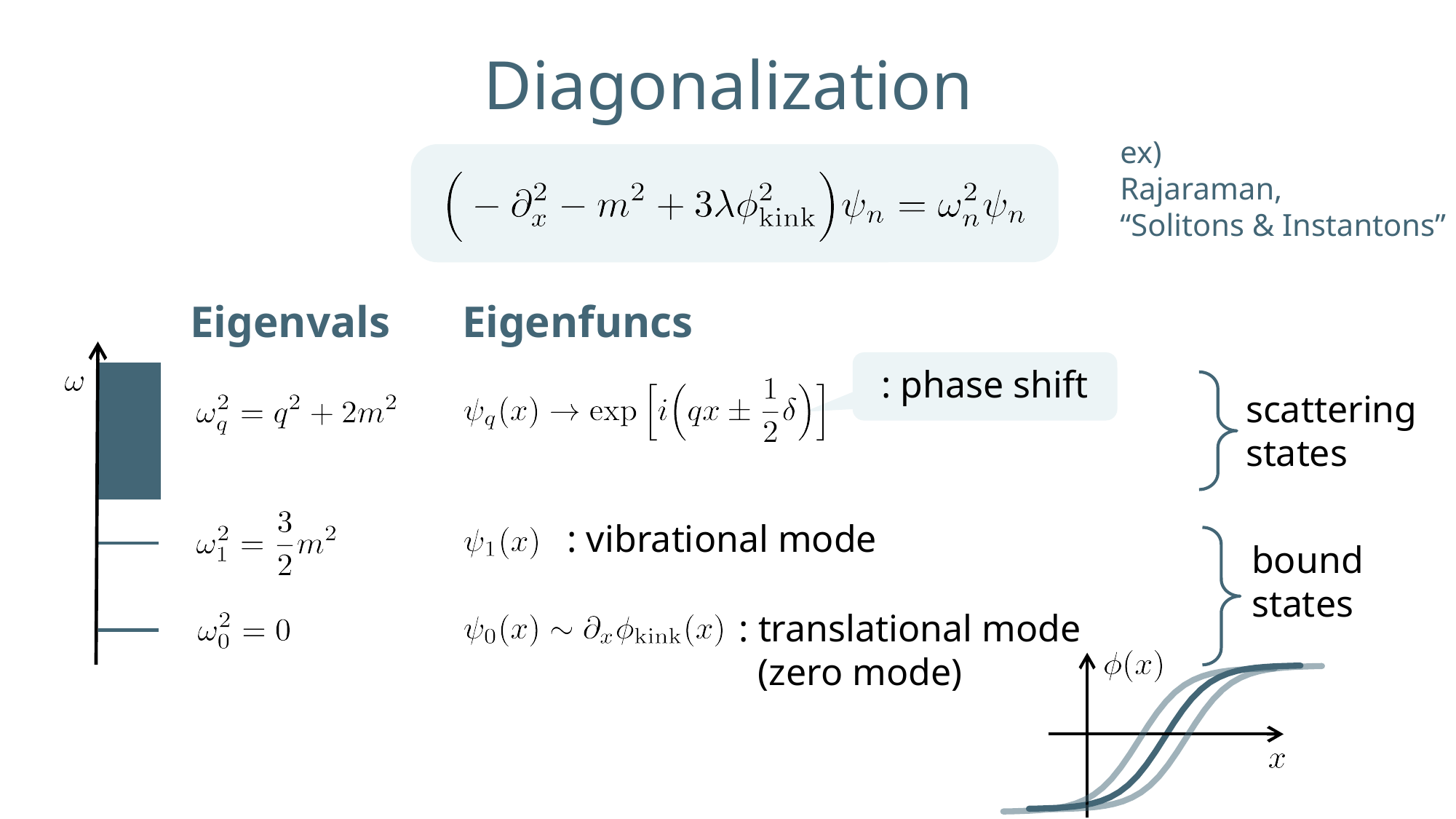
In the level diagram on the left, how many discrete horizontal level lines are drawn below the shaded continuum band? 2 In the bottom-right sketch, what is the label on the horizontal axis? x In the bottom-right sketch, do the curves rise or fall as x increases? rise In the bottom-right sketch, what is the label on the vertical axis? φ(x) How many curves are drawn in the bottom-right φ(x) sketch? 3 In the level diagram on the left, what is the label on the vertical axis? ω